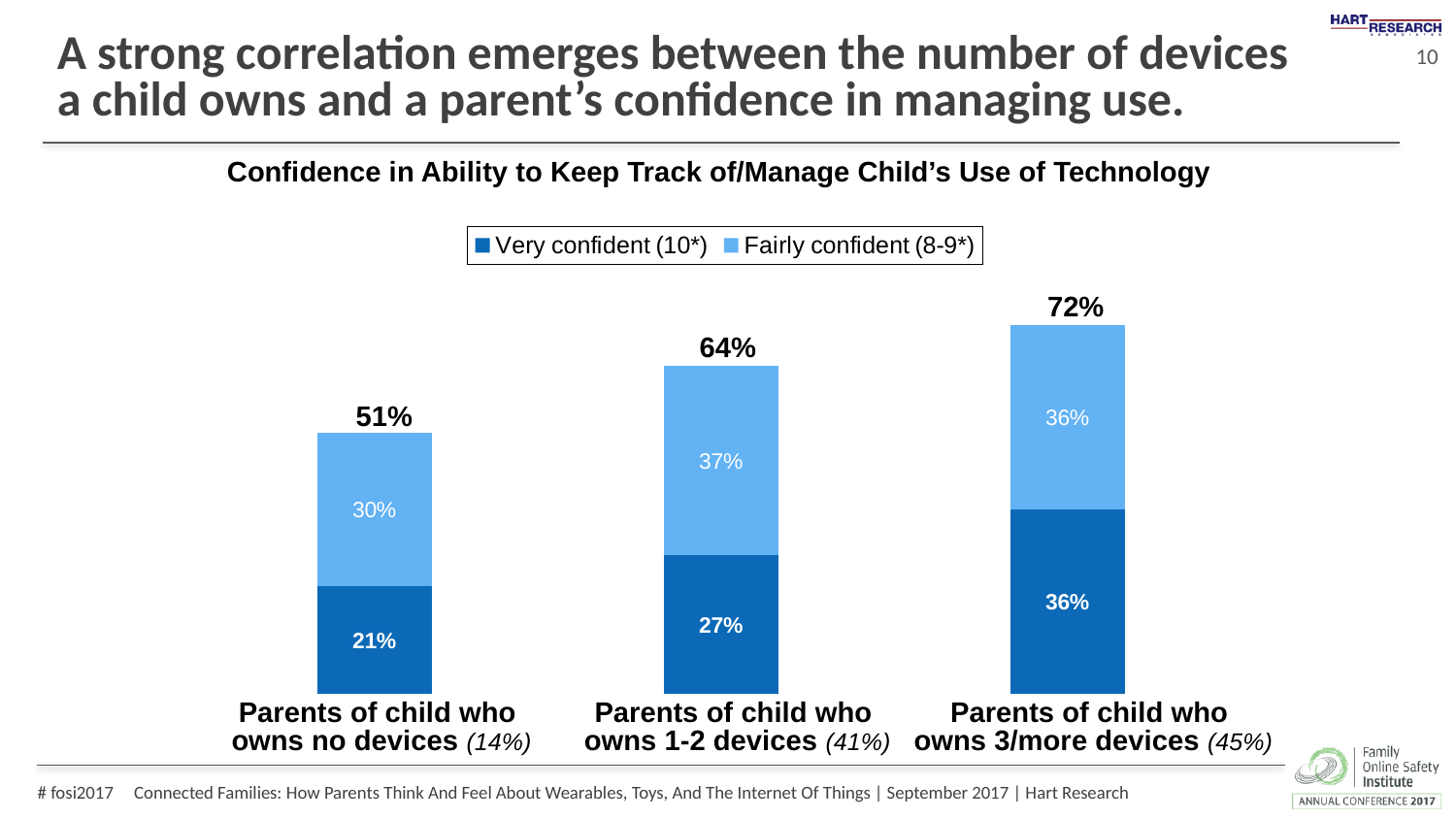
What percentage of parents of a child who owns 3/more devices are very confident (10*)? 36% What percentage of parents of a child who owns 1-2 devices are fairly confident (8-9*)? 37% Does total confidence rise or fall as the number of devices a child owns increases? Rises What kind of chart is shown on the slide? Stacked bar chart What is the difference in total confidence between parents of a child who owns 3/more devices and parents of a child who owns no devices? 21 percentage points Which is larger: the very confident share for parents of a child who owns 1-2 devices or for parents of a child who owns no devices? Parents of child who owns 1-2 devices How many series does the legend list? 2 Which group has the highest total confidence? Parents of child who owns 3/more devices Which group has the lowest share of very confident (10*) parents? Parents of child who owns no devices How many groups of parents are shown on the chart? 3 What percentage of parents of a child who owns no devices are very confident (10*)? 21% What is the total confident share (very plus fairly confident) for parents of a child who owns 1-2 devices? 64%